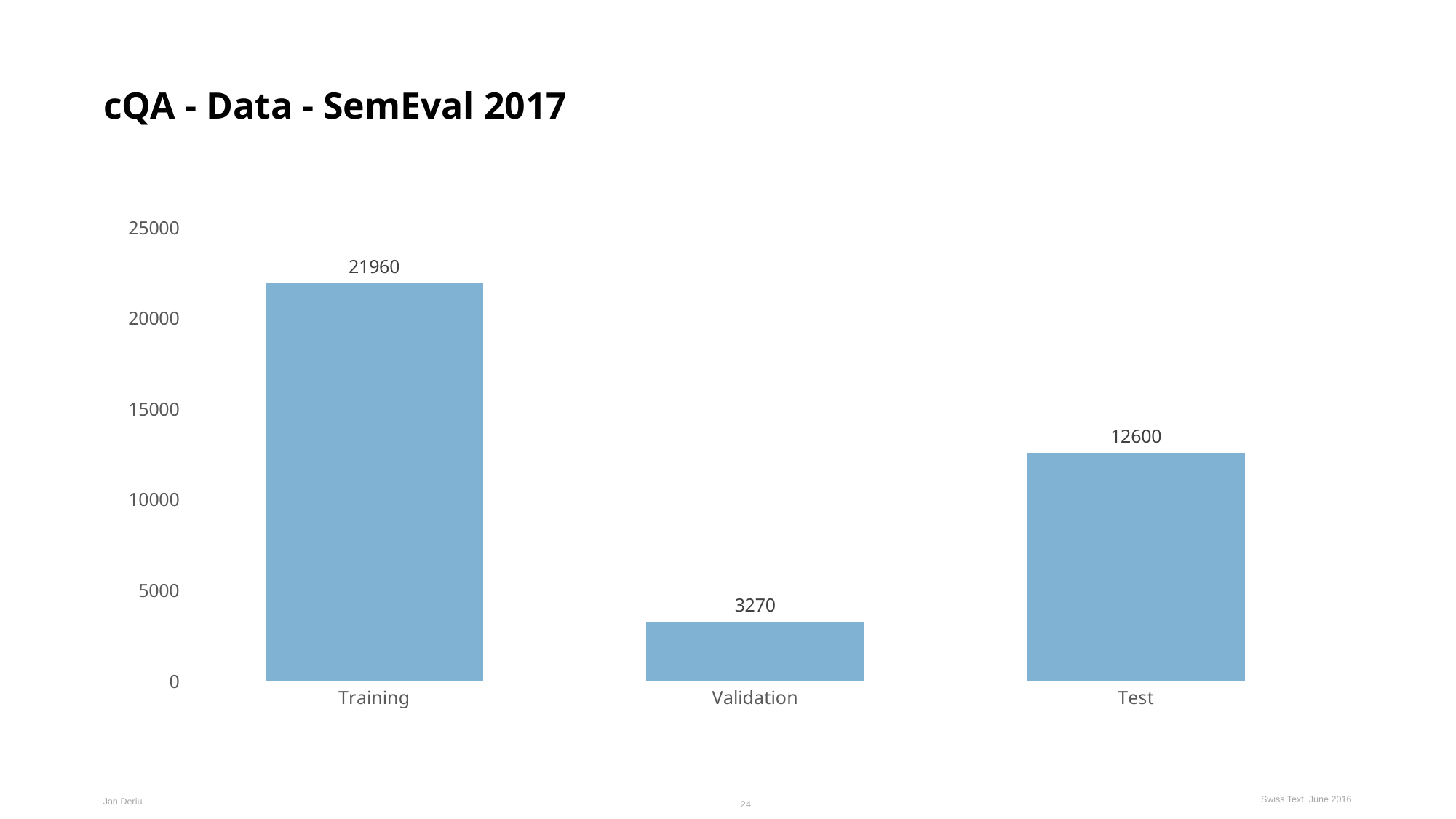
Is the value for Test greater or less than 10000? greater What is the value for Validation? 3270 What is the value for Training? 21960 Which category has the highest value? Training What is the title of the slide containing the chart? cQA - Data - SemEval 2017 What kind of chart is shown on the slide? bar chart Which is larger, the value for Test or the value for Validation? Test What is the difference between the Training and Test values? 9360 What is the difference between the Test and Validation values? 9330 What is the value for Test? 12600 How many categories are shown on the x axis? 3 Which category has the lowest value? Validation